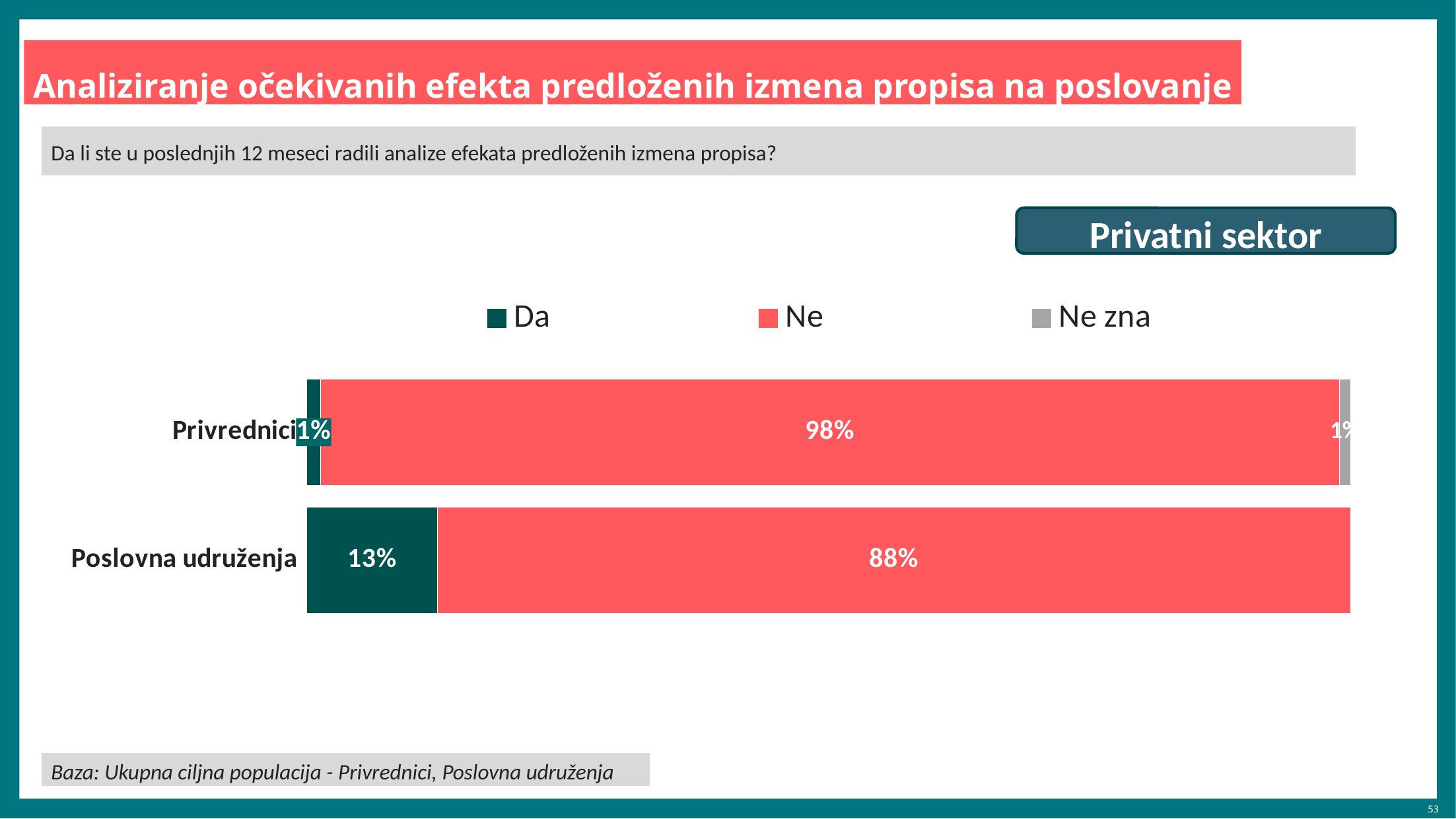
What percentage of Privrednici answered "Da"? 1% Which category has the higher share of "Da" answers, Privrednici or Poslovna udruženja? Poslovna udruženja How many series does the legend list? 3 What percentage of Privrednici answered "Ne"? 98% What percentage of Poslovna udruženja answered "Da"? 13% How many categories are shown on the chart? 2 What kind of chart is shown on the slide? Stacked bar chart What is the difference between the "Da" shares of Poslovna udruženja and Privrednici? 12 percentage points What is the difference between the "Ne" shares of Privrednici and Poslovna udruženja? 10 percentage points Which legend entry is shown in grey? Ne zna Which category has the highest share of "Ne" answers? Privrednici What percentage of Poslovna udruženja answered "Ne"? 88%